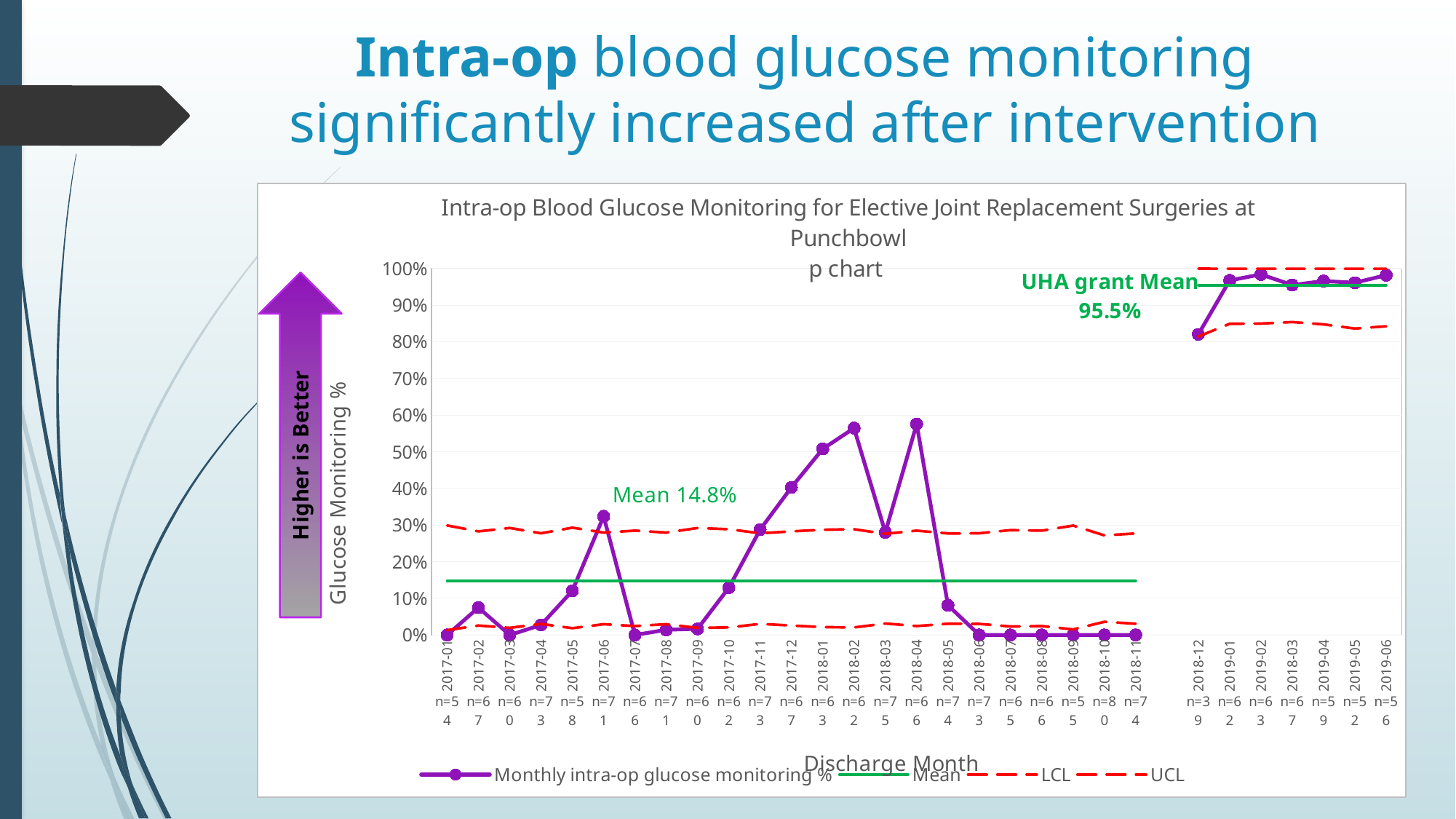
What is the UHA grant Mean value labelled on the chart? 95.5% How many discharge months are plotted on the x axis? 30 What is the mean value labelled for the pre-intervention period? 14.8% What kind of chart is shown on the slide? line chart Is the monthly intra-op glucose monitoring value for 2017-10 greater or less than 20%? less How many series does the legend list? 4 What is the monthly intra-op glucose monitoring value for 2018-06? 0% Is the monthly intra-op glucose monitoring value for 2018-02 greater or less than 50%? greater What is the title of the x axis? Discharge Month Is the monthly intra-op glucose monitoring value for 2019-02 greater or less than 90%? greater Which month has the larger monthly intra-op glucose monitoring value, 2017-06 or 2018-02? 2018-02 What is the difference between the UHA grant Mean and the earlier Mean of 14.8%? 80.7 percentage points